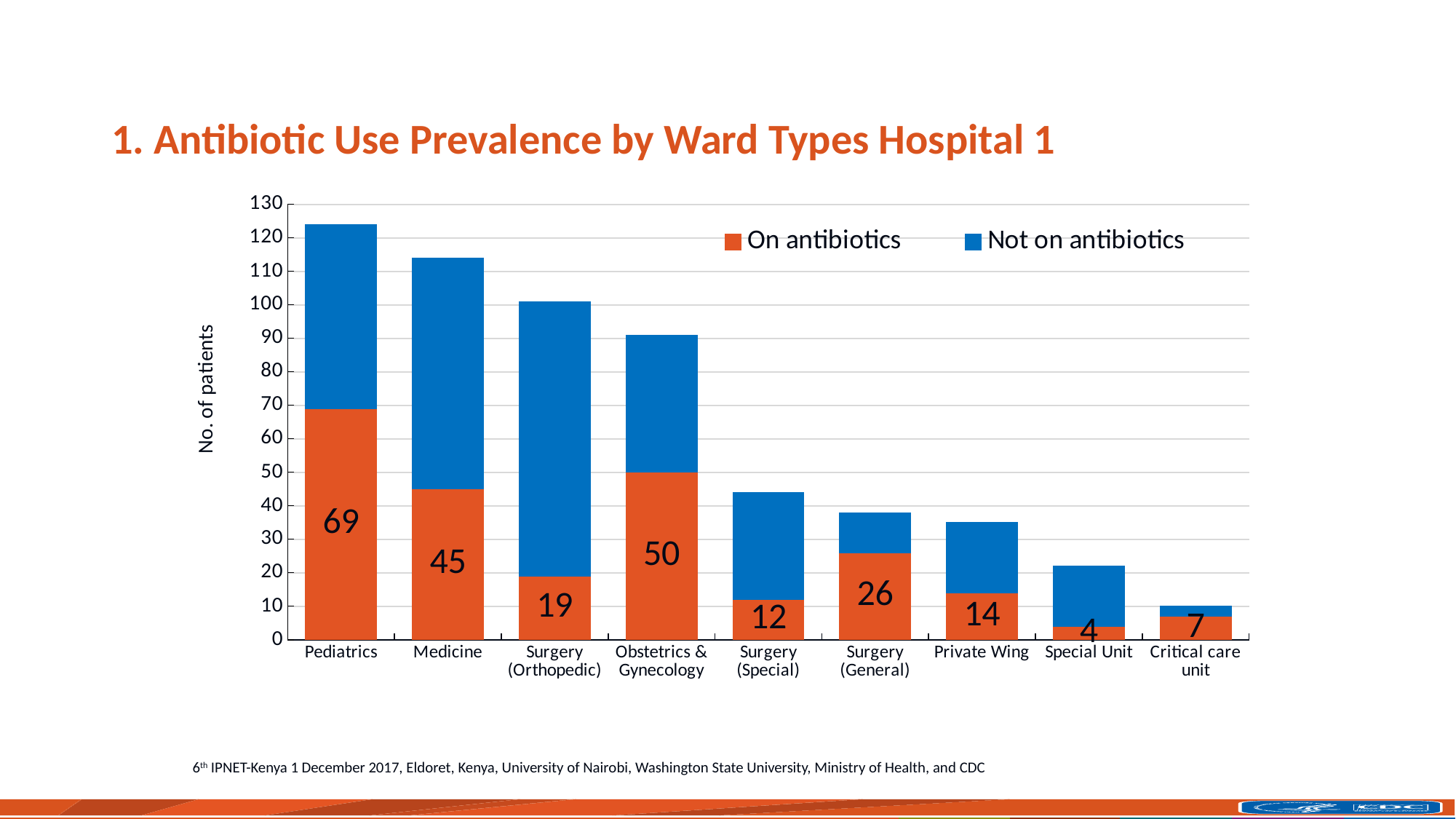
Which has more patients on antibiotics, Surgery (General) or Private Wing? Surgery (General) How many patients in Pediatrics were on antibiotics? 69 How many series does the legend list? 2 Which ward type has the highest number of patients on antibiotics? Pediatrics Is the total number of patients in Pediatrics greater or less than 120? greater How many ward types are shown on the x axis? 9 What kind of chart is shown on the slide? Stacked bar chart How many patients in Surgery (Orthopedic) were on antibiotics? 19 Which ward type has the lowest number of patients on antibiotics? Special Unit What is the label of the y axis? No. of patients What is the difference between the number of patients on antibiotics in Obstetrics & Gynecology and in Medicine? 5 How many patients in Special Unit were on antibiotics? 4